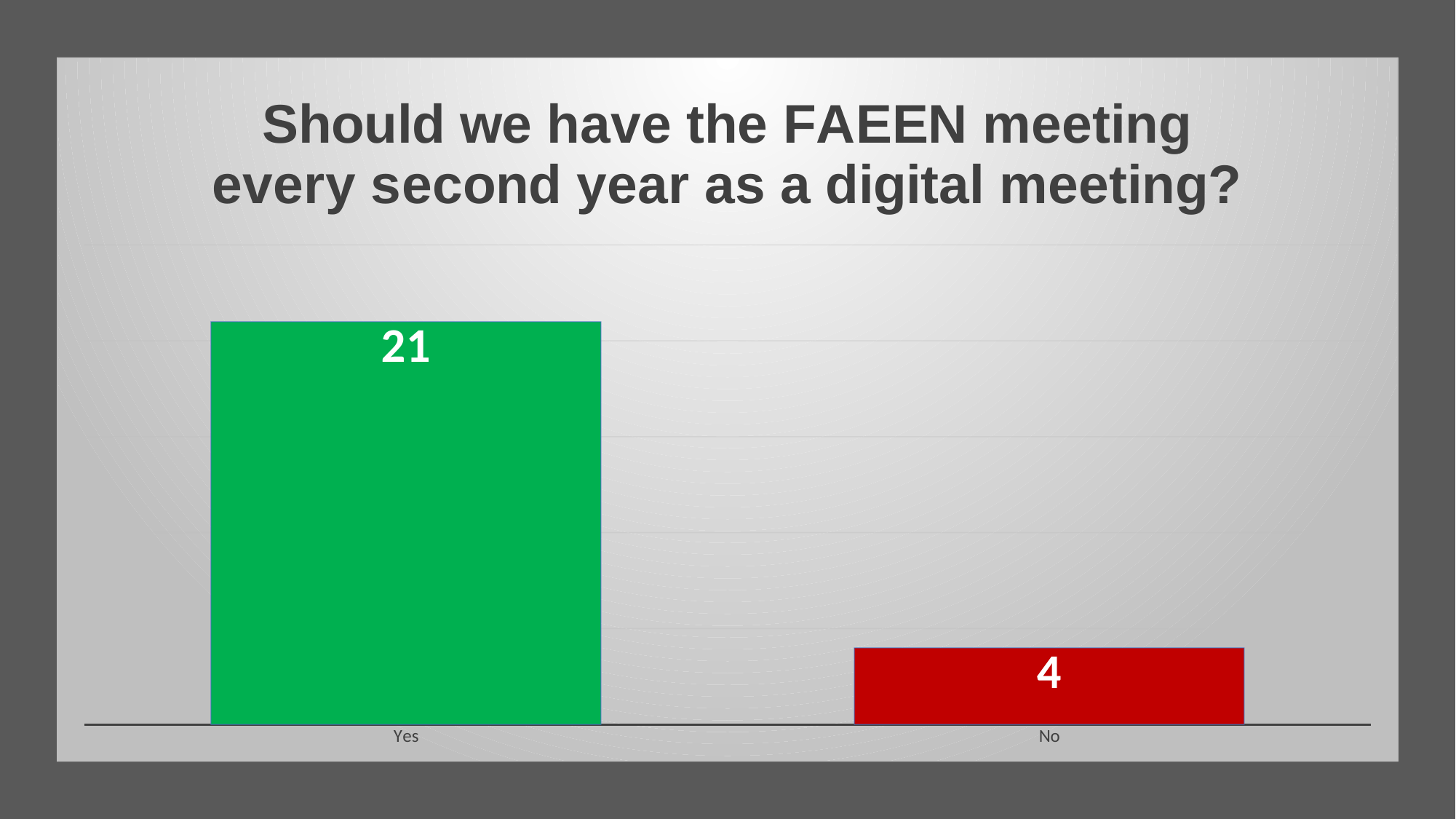
Which is larger, the value for Yes or the value for No? Yes What is the total of the values for Yes and No? 25 What is the value for No? 4 Which category has the lowest value? No What kind of chart is shown on the slide? Bar chart What is the title of the chart? Should we have the FAEEN meeting every second year as a digital meeting? How many categories are shown in the chart? 2 Which category has the highest value? Yes What colour is the bar for No? Red What is the value for Yes? 21 What is the difference between the values for Yes and No? 17